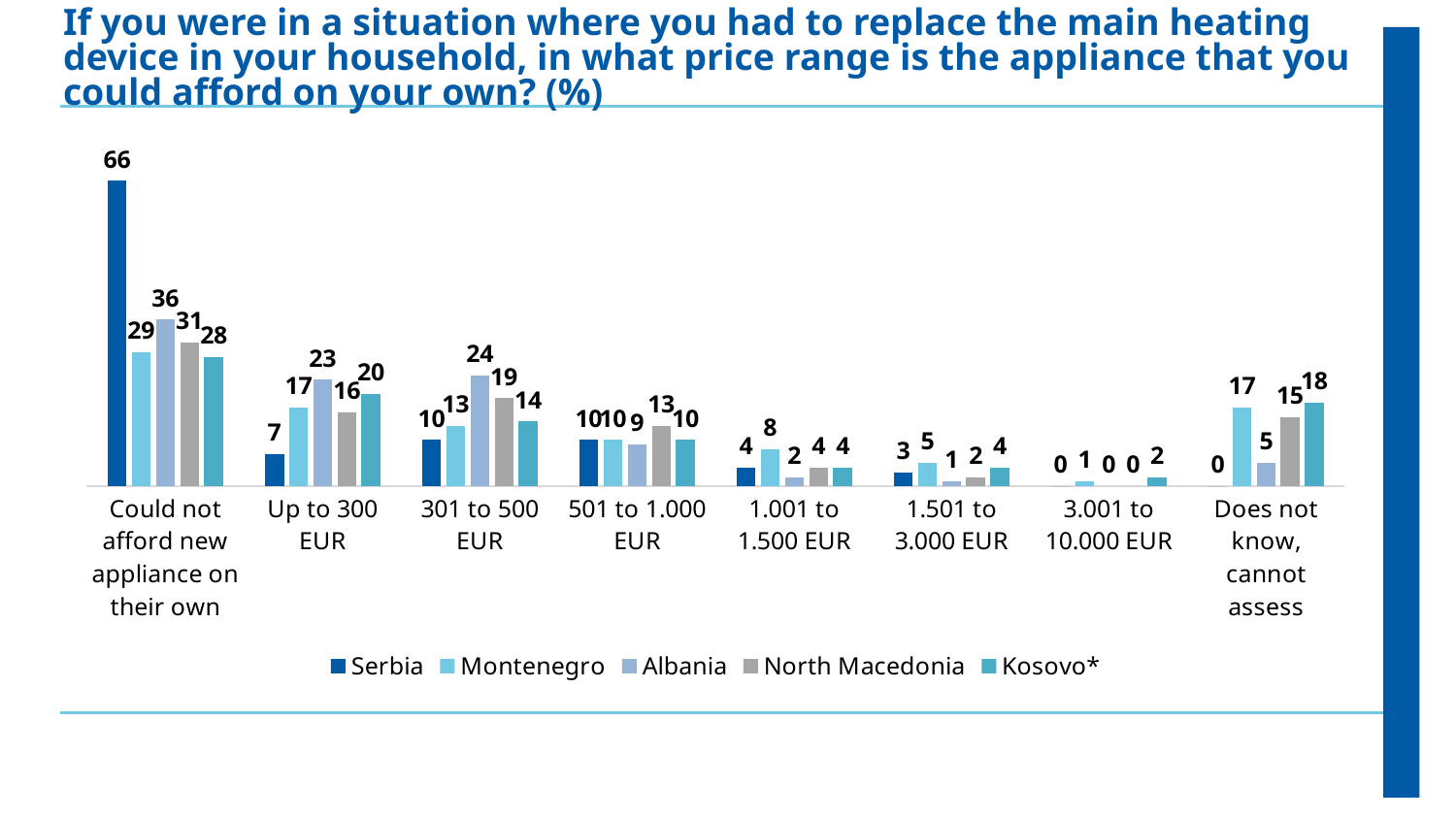
What is the value for Kosovo* in the "Does not know, cannot assess" category? 18 How many series does the legend list? 5 Which series is shown in the darkest blue colour in the legend? Serbia Which country has the highest value in the "Up to 300 EUR" category? Albania What is the value for Serbia in the "Could not afford new appliance on their own" category? 66 Which country has the lowest value in the "Does not know, cannot assess" category? Serbia How many price-range categories are shown on the x axis? 8 What is the difference between Serbia's and Montenegro's values in the "Could not afford new appliance on their own" category? 37 Which is larger in the "1.001 to 1.500 EUR" category: the value for Montenegro or the value for Albania? Montenegro What is the value for North Macedonia in the "501 to 1.000 EUR" category? 13 What kind of chart is shown on the slide? Bar chart What is the value for Albania in the "301 to 500 EUR" category? 24